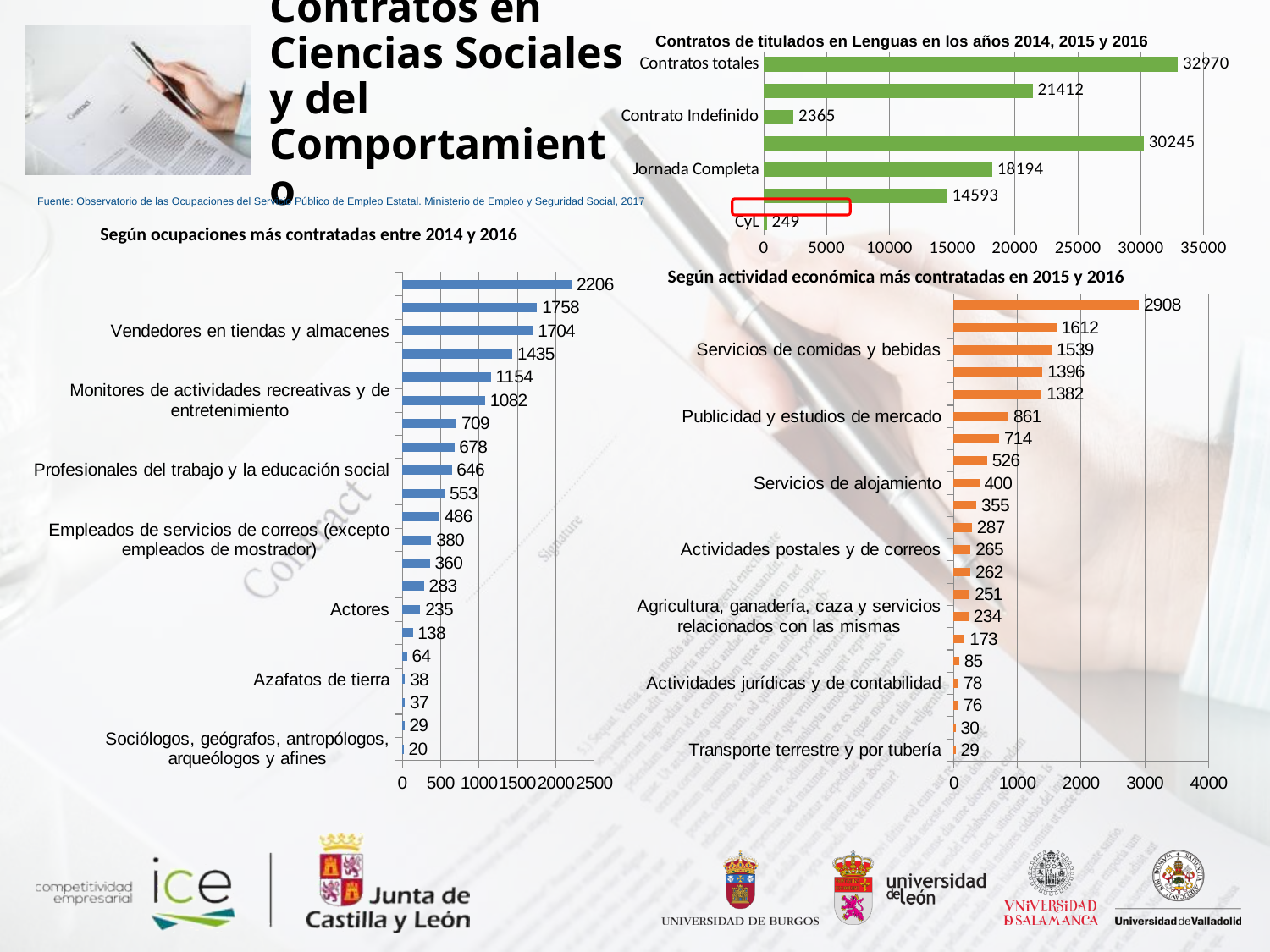
In the chart 'Según ocupaciones más contratadas entre 2014 y 2016', what is the value for 'Vendedores en tiendas y almacenes'? 1704 In the chart 'Según actividad económica más contratadas en 2015 y 2016', which is larger: 'Publicidad y estudios de mercado' or 'Actividades postales y de correos'? Publicidad y estudios de mercado How many bars are plotted in the chart 'Según ocupaciones más contratadas entre 2014 y 2016'? 21 In the chart 'Contratos de titulados en Lenguas en los años 2014, 2015 y 2016', what is the value for 'CyL'? 249 In the chart 'Según actividad económica más contratadas en 2015 y 2016', what is the difference between 'Servicios de comidas y bebidas' and 'Servicios de alojamiento'? 1139 In the chart 'Contratos de titulados en Lenguas en los años 2014, 2015 y 2016', what is the value of the bar labelled 'Contratos totales'? 32970 In the chart 'Según ocupaciones más contratadas entre 2014 y 2016', what is the difference between 'Vendedores en tiendas y almacenes' and 'Actores'? 1469 In the chart 'Según ocupaciones más contratadas entre 2014 y 2016', is the value for 'Monitores de actividades recreativas y de entretenimiento' greater or less than 1000? greater In the chart 'Contratos de titulados en Lenguas en los años 2014, 2015 y 2016', what is the value of the bar labelled 'Jornada Completa'? 18194 In the chart 'Según ocupaciones más contratadas entre 2014 y 2016', which labelled occupation has the lowest value? Sociólogos, geógrafos, antropólogos, arqueólogos y afines In the chart 'Según actividad económica más contratadas en 2015 y 2016', what is the value for 'Servicios de comidas y bebidas'? 1539 What type of chart is 'Según actividad económica más contratadas en 2015 y 2016'? bar chart